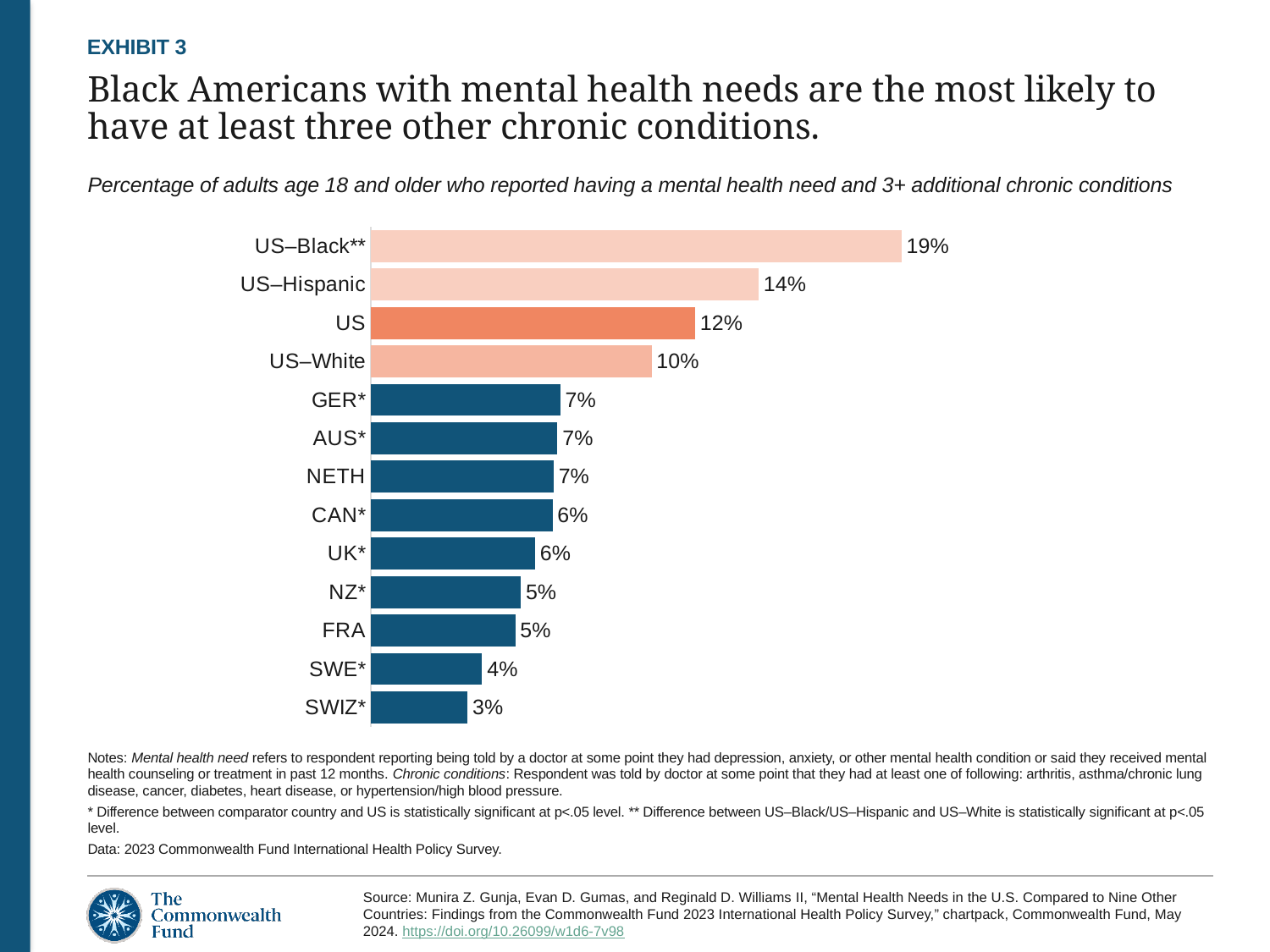
What is the value for US–Black**? 19% Which category has the highest value? US–Black** Which is larger, the value for US–Hispanic or the value for US? US–Hispanic What kind of chart is shown on the slide? Bar chart Which category has the lowest value? SWIZ* What is the exhibit number shown at the top of the slide? Exhibit 3 Which is larger, the value for GER* or the value for NZ*? GER* How many categories are shown in the chart? 13 What is the difference between the values for US–Black** and US–White? 9% What is the value for SWE*? 4% What is the value for US–Hispanic? 14% What is the difference between the values for US and SWIZ*? 9%